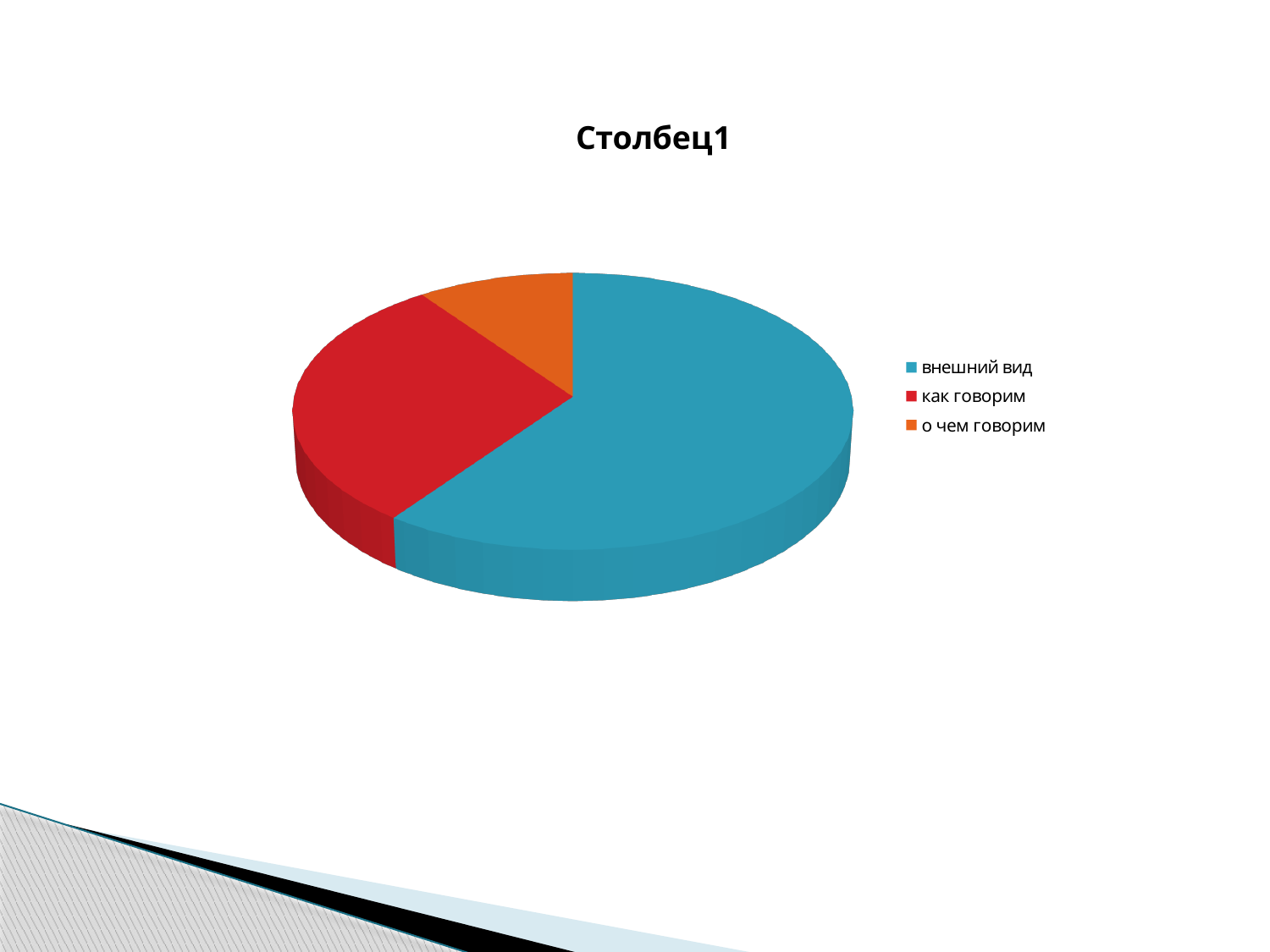
How many entries does the legend list? 3 What is the title of the chart? Столбец1 Which slice is larger, "как говорим" or "о чем говорим"? как говорим Which category has the largest slice of the pie? внешний вид Which category has the smallest slice of the pie? о чем говорим What kind of chart is shown on the slide? pie chart How many slices does the pie chart have? 3 Which slice is larger, "внешний вид" or "как говорим"? внешний вид Does the slice for "внешний вид" take up more or less than half of the pie? more What colour is the slice for "как говорим"? red